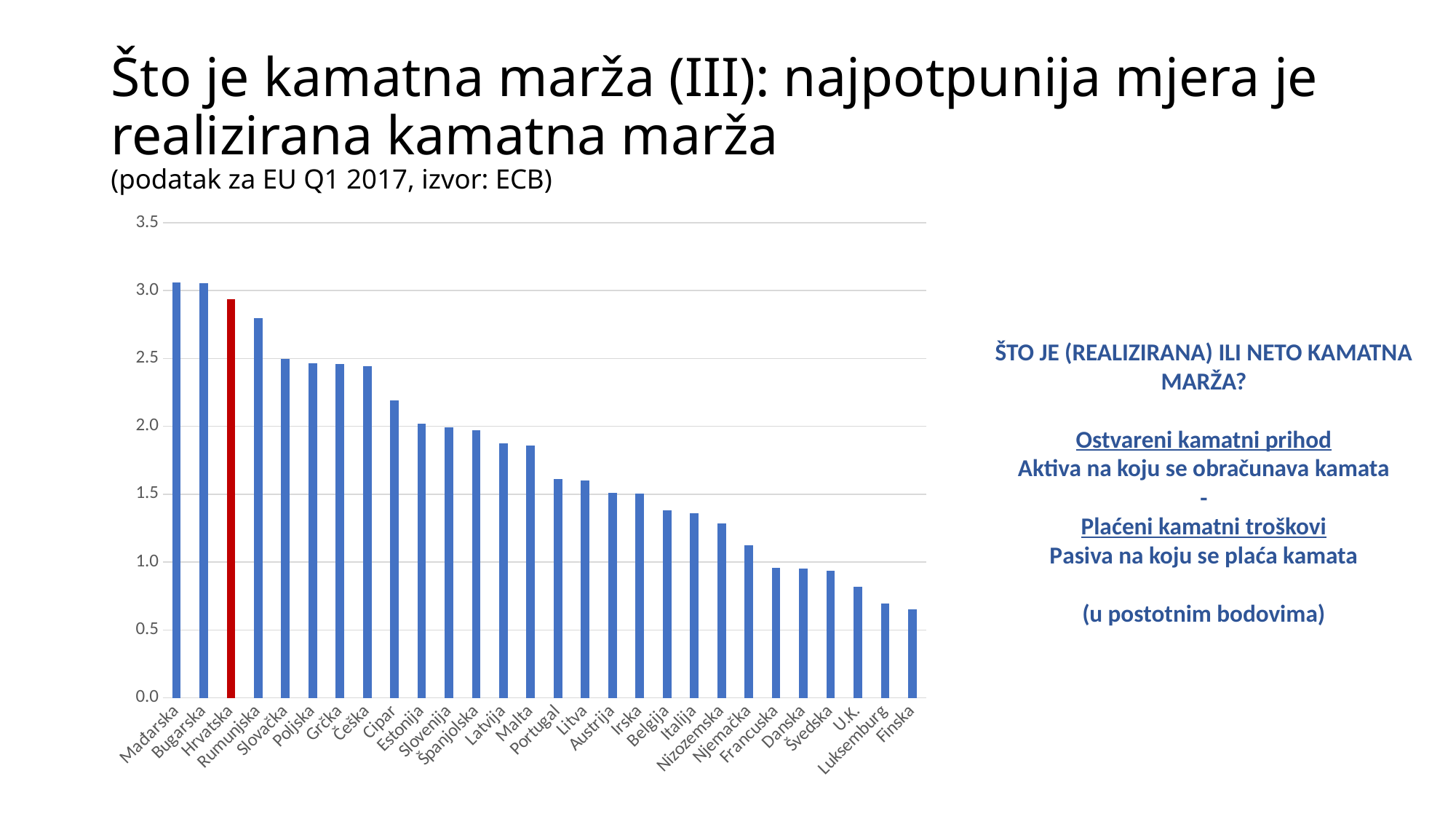
Is the value for Portugal greater or less than 2.0? less Is the value for Finska greater or less than 1.0? less How many countries are shown on the x axis of the chart? 28 What kind of chart is shown on the slide? bar chart Which country's bar is coloured red in the chart? Hrvatska Is the value for Rumunjska greater or less than 3.0? less Which country has the lowest value in the chart? Finska Do the values rise or fall from left to right along the x axis? fall Which has a larger value, Hrvatska or Rumunjska? Hrvatska